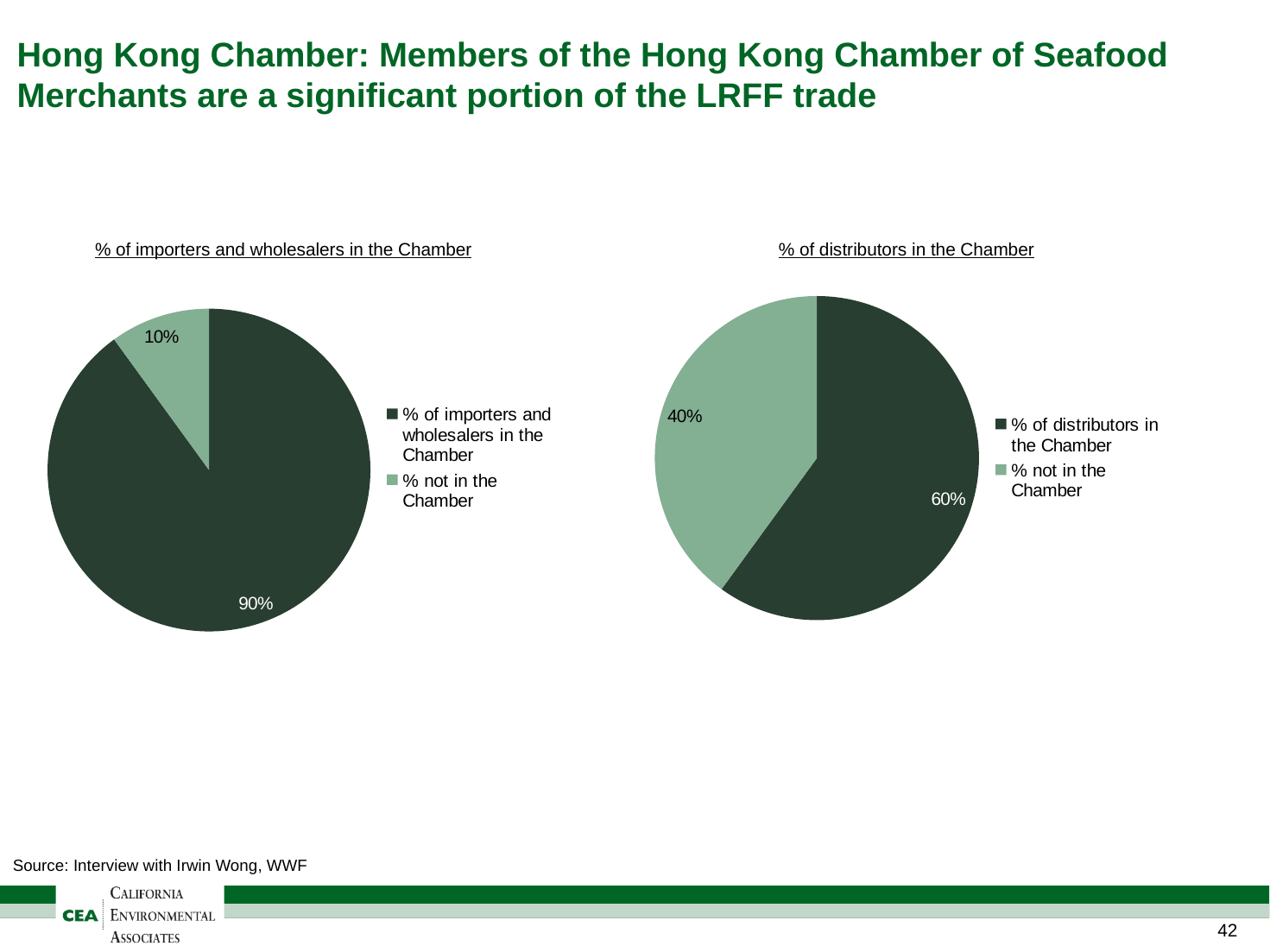
Which chart on the slide has the larger '% not in the Chamber' slice: the importers and wholesalers chart or the distributors chart? The distributors chart In the '% of importers and wholesalers in the Chamber' chart, which slice is the smallest? % not in the Chamber What kind of chart is the '% of importers and wholesalers in the Chamber' chart? Pie chart In the '% of distributors in the Chamber' chart, which slice is larger: '% of distributors in the Chamber' or '% not in the Chamber'? % of distributors in the Chamber How many entries does the legend of the '% of importers and wholesalers in the Chamber' chart list? 2 In the '% of distributors in the Chamber' chart, what share is labelled '% not in the Chamber'? 40% In the '% of importers and wholesalers in the Chamber' chart, what share is labelled '% not in the Chamber'? 10% In the '% of importers and wholesalers in the Chamber' chart, what is the difference between the two slices? 80% In the '% of distributors in the Chamber' chart, what is the difference between the '% of distributors in the Chamber' slice and the '% not in the Chamber' slice? 20% In the '% of importers and wholesalers in the Chamber' chart, what share of importers and wholesalers are in the Chamber? 90% How many slices does the '% of distributors in the Chamber' pie chart have? 2 In the '% of distributors in the Chamber' chart, what share of distributors are in the Chamber? 60%